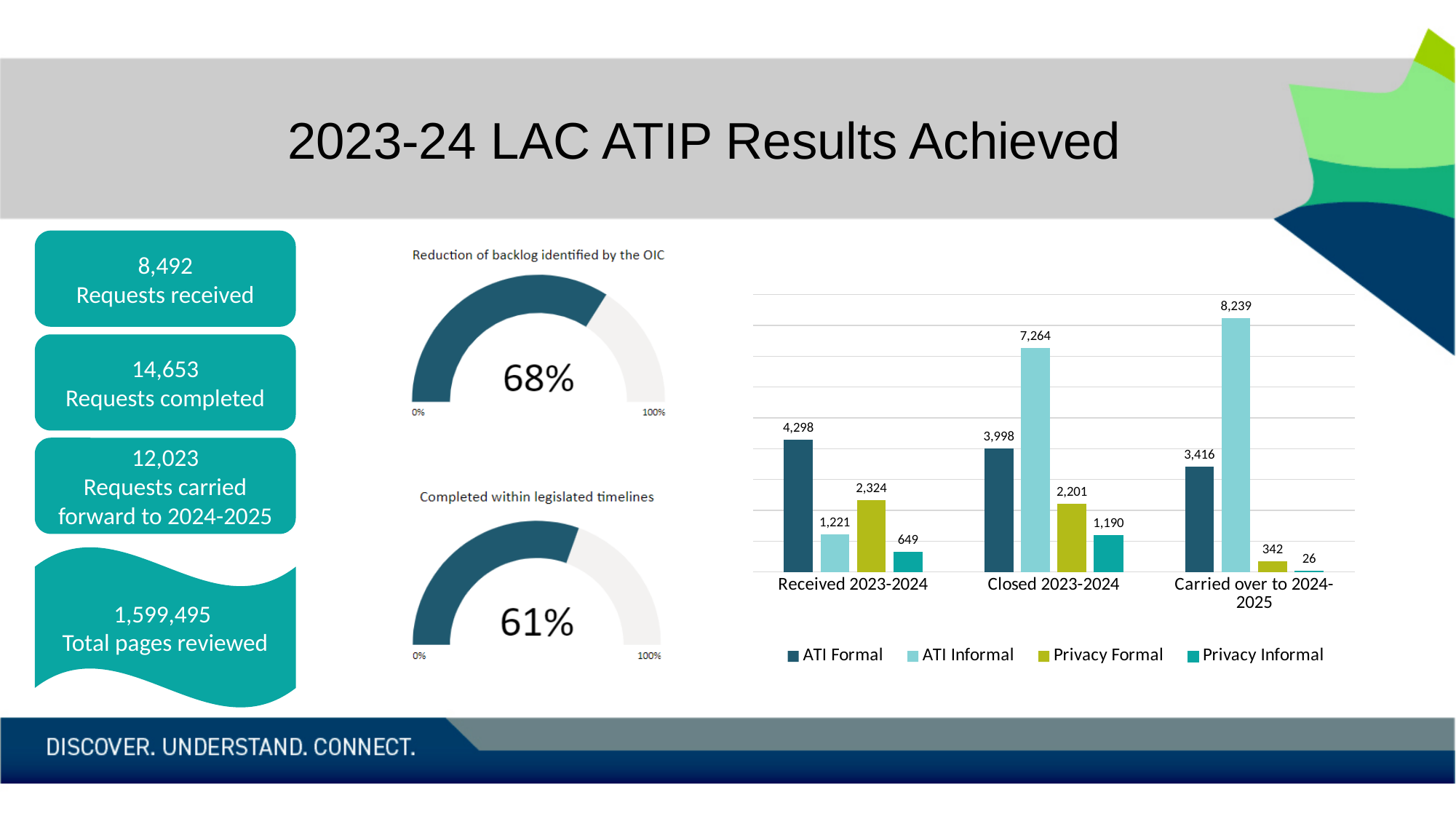
What value does the gauge chart titled 'Completed within legislated timelines' show? 61% In the bar chart on the right, which series has the lowest value in Received 2023-2024? Privacy Informal In the bar chart on the right, what is the value for ATI Formal in Received 2023-2024? 4,298 How many categories are shown on the x axis of the bar chart on the right? 3 In the bar chart on the right, what is the value for ATI Informal in Closed 2023-2024? 7,264 In the bar chart on the right, what is the value for Privacy Informal in Carried over to 2024-2025? 26 In the bar chart on the right, which is larger: Privacy Formal in Received 2023-2024 or Privacy Formal in Closed 2023-2024? Privacy Formal in Received 2023-2024 What value does the gauge chart titled 'Reduction of backlog identified by the OIC' show? 68% How many series does the legend of the bar chart on the right list? 4 In the bar chart on the right, which series has the highest value in Carried over to 2024-2025? ATI Informal What kind of chart is the chart on the right of the slide? Bar chart In the bar chart on the right, what is the difference between ATI Informal and ATI Formal in Closed 2023-2024? 3,266